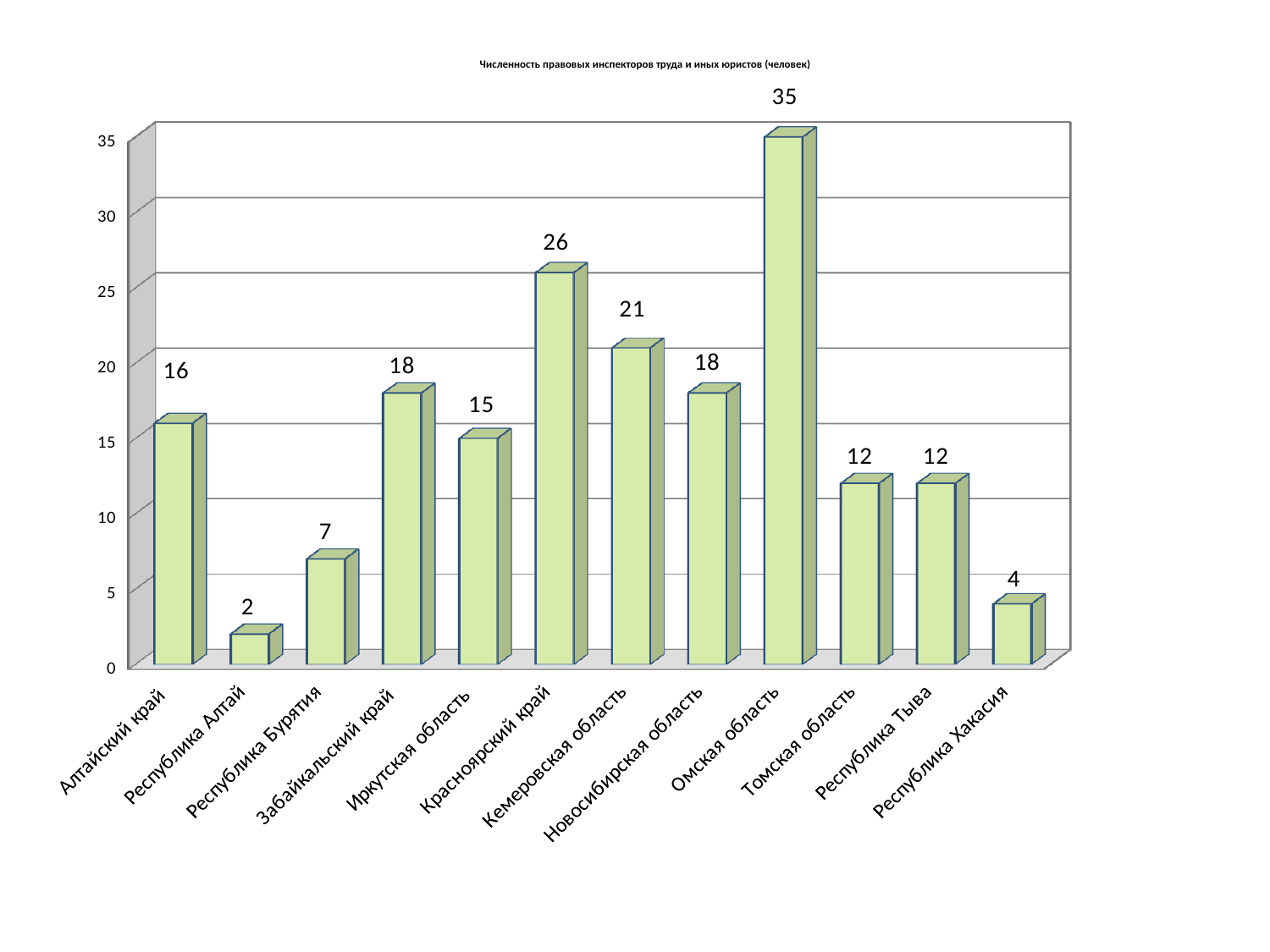
What is the value for Красноярский край? 26 What is the difference between the values for Омская область and Красноярский край? 9 How many categories are shown on the x axis? 12 What kind of chart is this? Bar chart Which is larger, the value for Кемеровская область or the value for Иркутская область? Кемеровская область What is the value for Омская область? 35 What is the title of the chart? Численность правовых инспекторов труда и иных юристов (человек) Which category has the highest value? Омская область Which two categories both have a value of 12? Томская область and Республика Тыва What is the value for Республика Бурятия? 7 Which category has the lowest value? Республика Алтай What is the difference between the values for Алтайский край and Республика Хакасия? 12